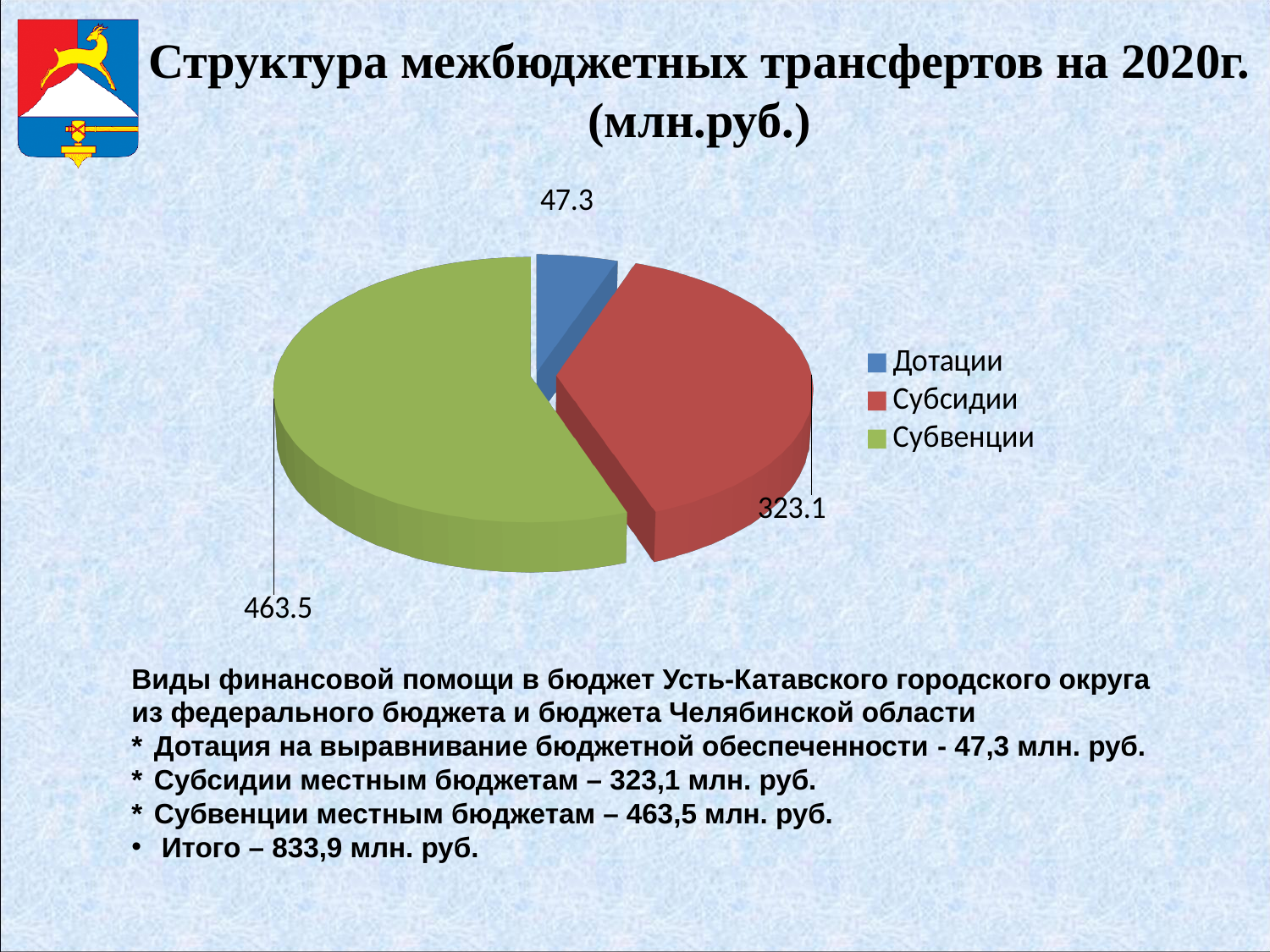
What is the difference between the values for Субвенции and Субсидии? 140.4 What colour is the Субвенции slice in the pie chart? Green What is the value for Дотации on the pie chart? 47.3 Which category has the largest slice of the pie chart? Субвенции What is the difference between the values for Субсидии and Дотации? 275.8 What is the value for Субвенции on the pie chart? 463.5 Which is larger, the value for Субсидии or the value for Дотации? Субсидии What is the value for Субсидии on the pie chart? 323.1 How many entries does the legend list? 3 Which category has the smallest slice of the pie chart? Дотации How many slices does the pie chart have? 3 What kind of chart is shown on the slide? Pie chart